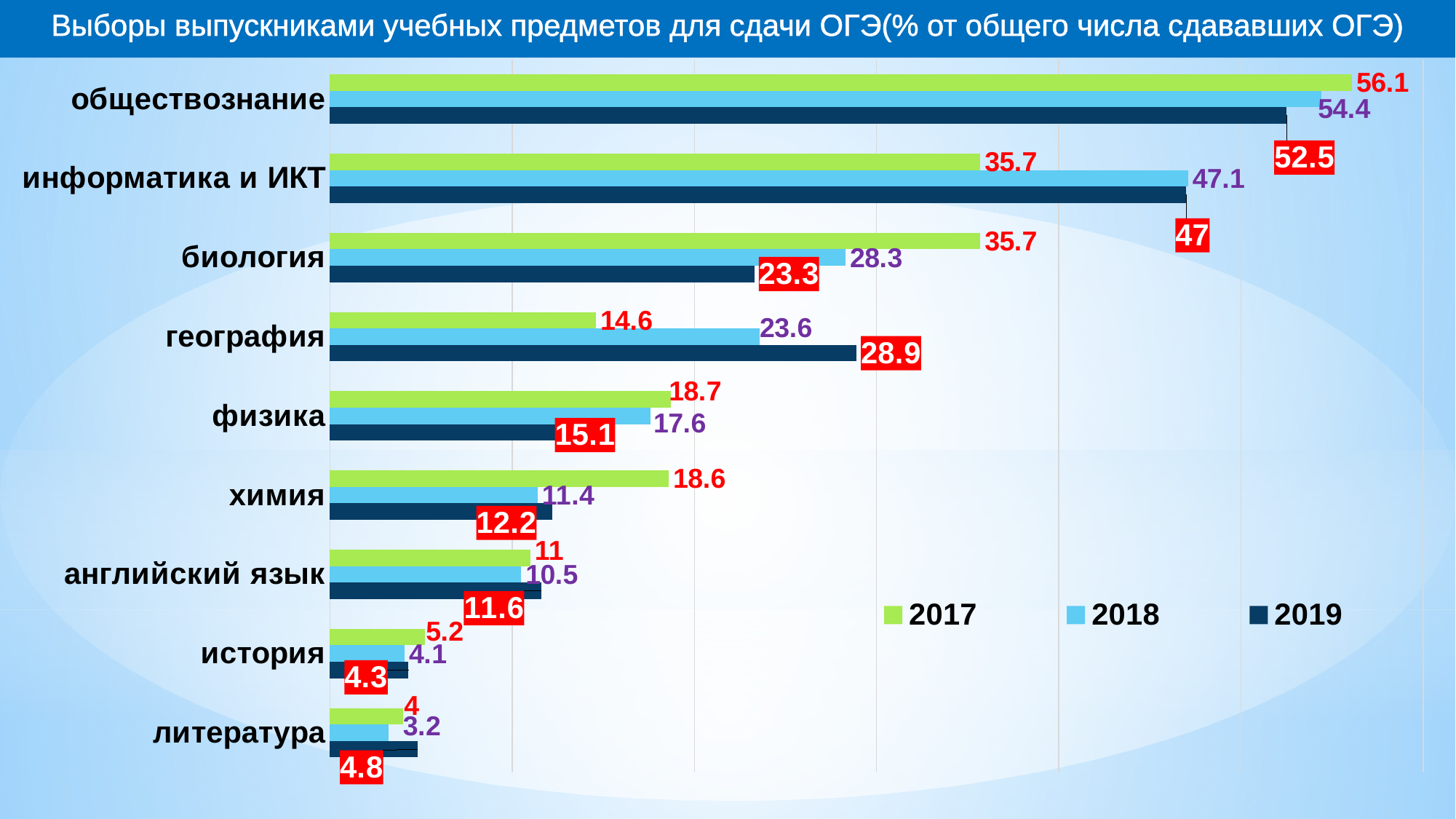
Which subject has the highest value in 2017? обществознание How many series does the legend list? 3 How many subjects (categories) are shown on the chart? 9 What is the value for обществознание in 2019? 52.5 Which subject has the lowest value in 2018? литература Do the values for география rise or fall from 2017 to 2019? rise What is the value for литература in 2017? 4 What type of chart is shown on the slide? bar chart Which is larger for биология: the 2017 value or the 2019 value? 2017 What is the difference between the 2018 and 2017 values for информатика и ИКТ? 11.4 Which year is represented by the green bars in the legend? 2017 What is the value for география in 2018? 23.6